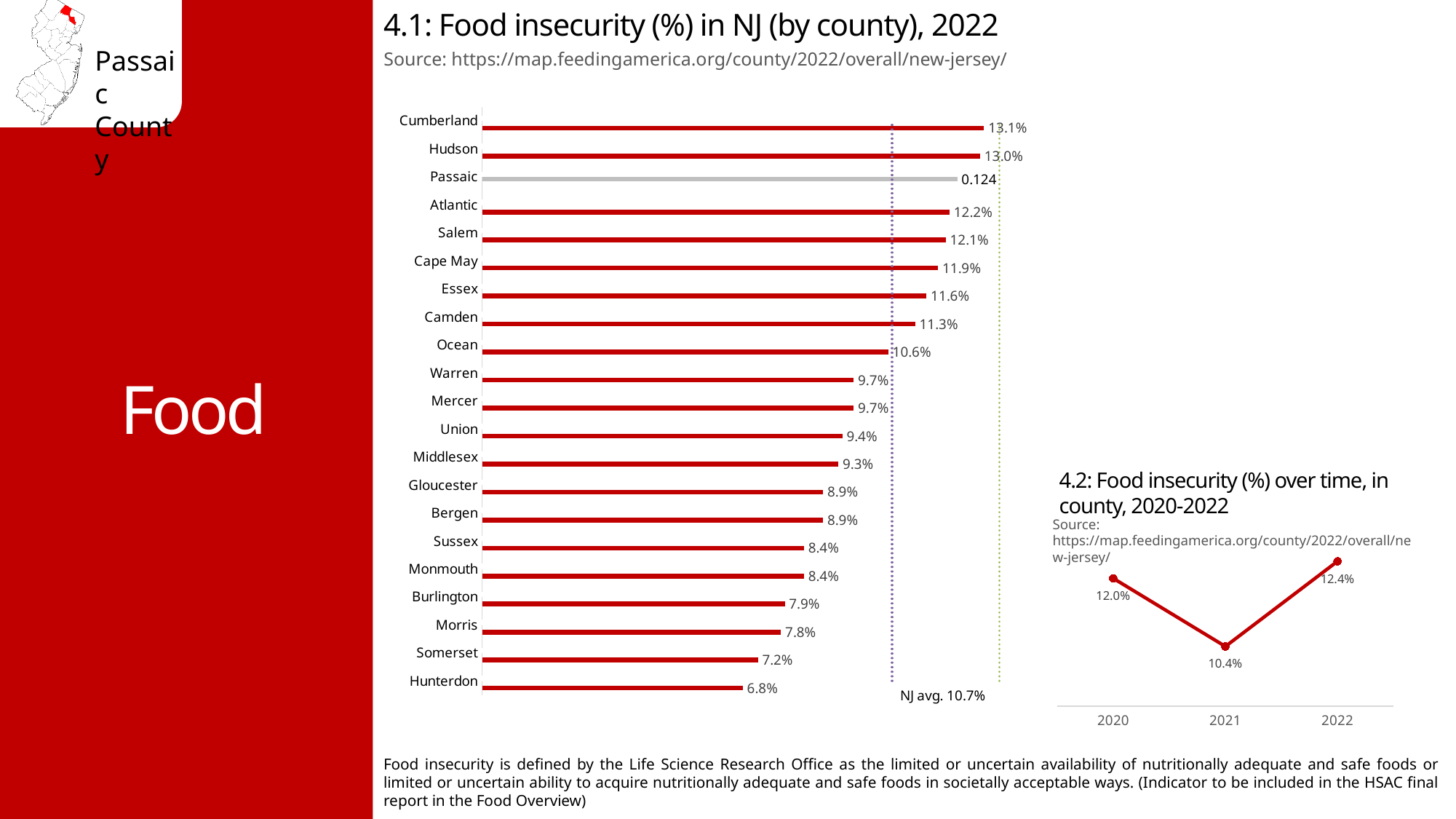
In chart 4.1 (Food insecurity in NJ by county, 2022), what is the value for Cumberland? 13.1% What kind of chart is chart 4.1 (Food insecurity in NJ by county, 2022)? Bar chart In chart 4.1 (Food insecurity in NJ by county, 2022), what is the value shown for Passaic? 0.124 What kind of chart is chart 4.2 (Food insecurity over time, 2020-2022)? Line chart In chart 4.1 (Food insecurity in NJ by county, 2022), what is the difference between Atlantic and Hunterdon? 5.4% In chart 4.1 (Food insecurity in NJ by county, 2022), which county has the highest value? Cumberland In chart 4.1 (Food insecurity in NJ by county, 2022), which county has the lowest value? Hunterdon In chart 4.1 (Food insecurity in NJ by county, 2022), what NJ average value is labelled on the chart? 10.7% In chart 4.1 (Food insecurity in NJ by county, 2022), which is larger, Essex or Ocean? Essex In chart 4.2 (Food insecurity over time, 2020-2022), what is the difference between 2022 and 2020? 0.4% In chart 4.2 (Food insecurity over time, 2020-2022), what is the value for 2021? 10.4% In chart 4.1 (Food insecurity in NJ by county, 2022), how many counties are plotted? 21